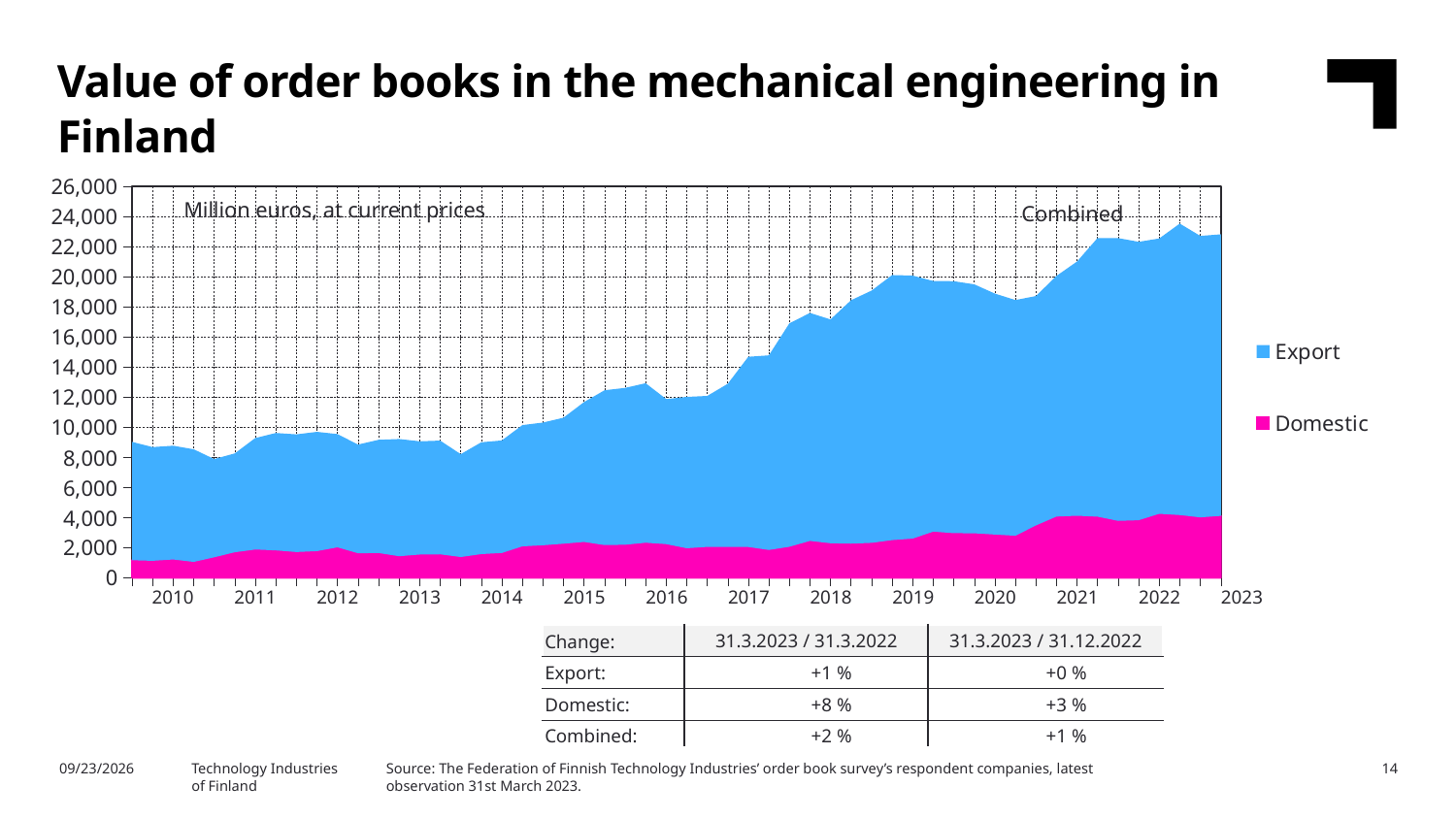
Is the combined value at the start of 2010 greater or less than 10,000? less Is the Domestic value in 2022 greater or less than 3,000? greater How many series does the chart legend list? 2 Which series is larger throughout the chart, Export or Domestic? Export What unit is stated on the chart for the values? Million euros, at current prices How many years are labelled on the x axis of the chart? 14 What kind of chart is shown on the slide? Area chart Is the combined value in 2022 greater or less than 20,000? greater Which two series are listed in the chart legend? Export and Domestic Does the combined value of order books generally rise or fall from 2010 to 2023? Rise